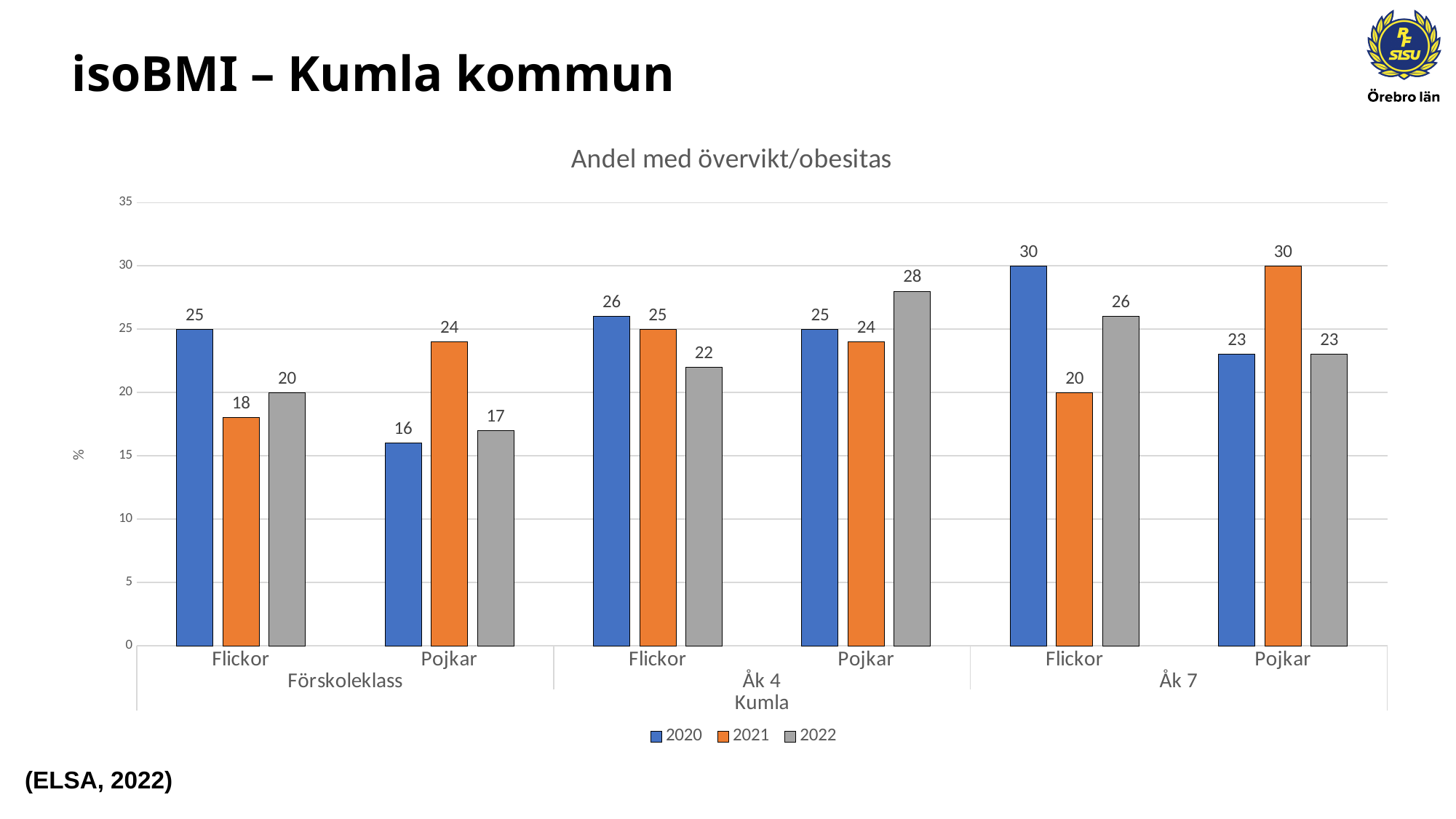
What is the 2022 value for Pojkar in Åk 4? 28 How many series does the legend list? 3 Which group and year has the lowest value on the chart? Pojkar in Förskoleklass, 2020 (16) For Flickor in Förskoleklass, do the values rise or fall from 2020 to 2021? Fall What is the 2020 value for Flickor in Förskoleklass? 25 Is the 2022 value for Pojkar in Åk 4 greater or less than 25? greater What is the 2021 value for Flickor in Åk 7? 20 Which is larger for Pojkar in Förskoleklass: the 2021 value or the 2022 value? 2021 What is the title of the chart? Andel med övervikt/obesitas What kind of chart is shown? Bar chart What is the highest value shown on the chart? 30 What is the difference between the 2020 and 2021 values for Flickor in Åk 7? 10